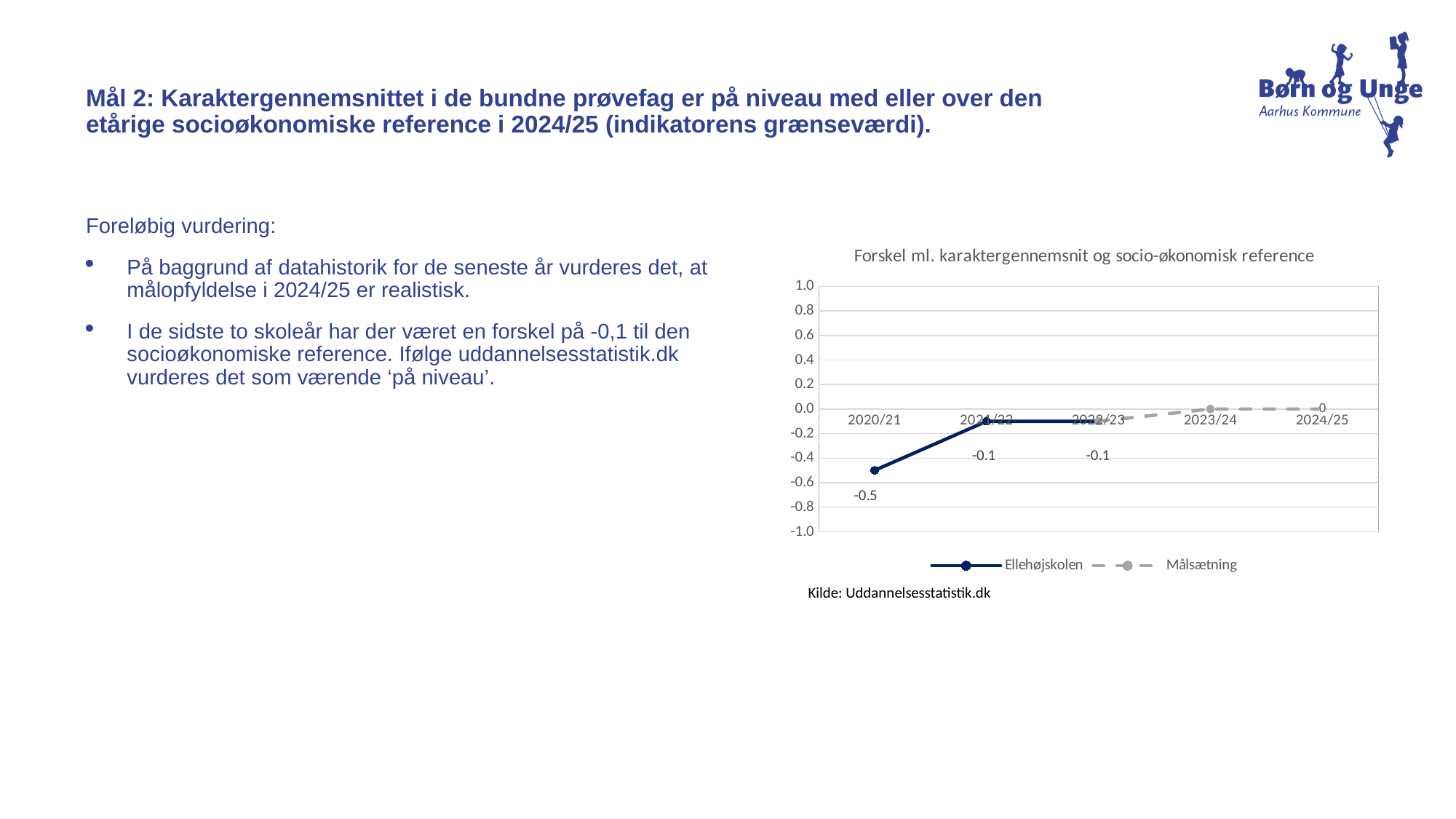
How many school years are shown on the x axis? 5 Does the Ellehøjskolen line rise or fall from 2020/21 to 2021/22? rise What is the value for Målsætning in 2024/25? 0 What is the title of the chart? Forskel ml. karaktergennemsnit og socio-økonomisk reference In which year is the Ellehøjskolen value lowest? 2020/21 How many series does the chart legend list? 2 What is the value for Ellehøjskolen in 2022/23? -0.1 What is the difference between the Ellehøjskolen values for 2021/22 and 2020/21? 0.4 What is the value for Ellehøjskolen in 2020/21? -0.5 What are the names of the two series in the legend? Ellehøjskolen and Målsætning What is the value for Ellehøjskolen in 2021/22? -0.1 What type of chart is shown on the slide? line chart